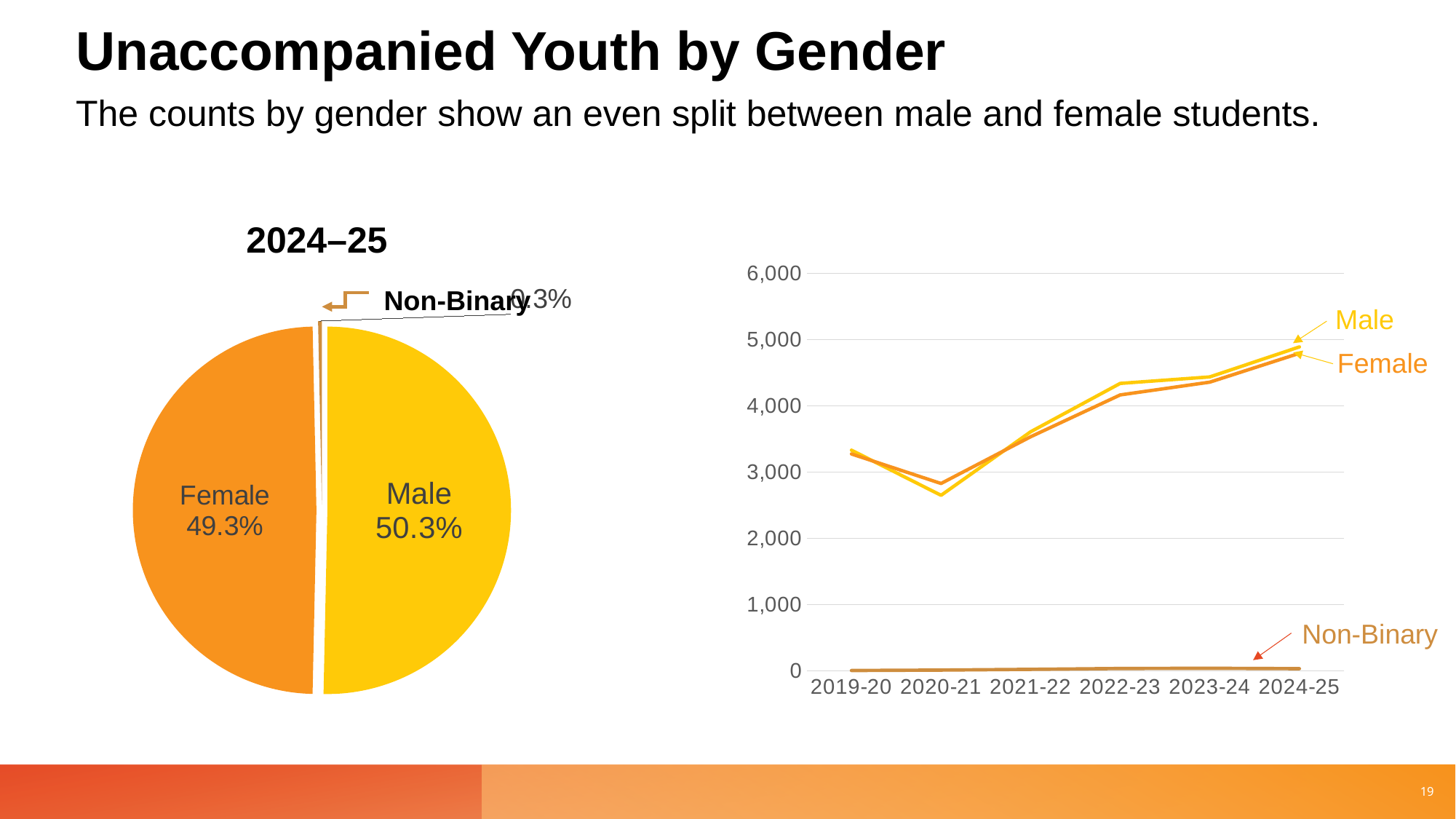
In the line chart on the right, is the Male value for 2020-21 greater or less than 3,000? less What kind of chart is the chart on the left of the slide? Pie chart In the pie chart titled 2024–25, by how many percentage points does the Male share exceed the Female share? 1.0% In the pie chart titled 2024–25, which category has the largest slice? Male In the line chart on the right, how many series are plotted? 3 In the pie chart titled 2024–25, which category has the smallest slice? Non-Binary In the pie chart titled 2024–25, what share of unaccompanied youth is Male? 50.3% In the pie chart titled 2024–25, what share of unaccompanied youth is Female? 49.3% In the line chart on the right, how many school years are shown on the x axis? 6 In the pie chart titled 2024–25, what share is Non-Binary? 0.3% In the line chart on the right, which year has the lowest Male value? 2020-21 What kind of chart is the chart on the right of the slide? Line chart